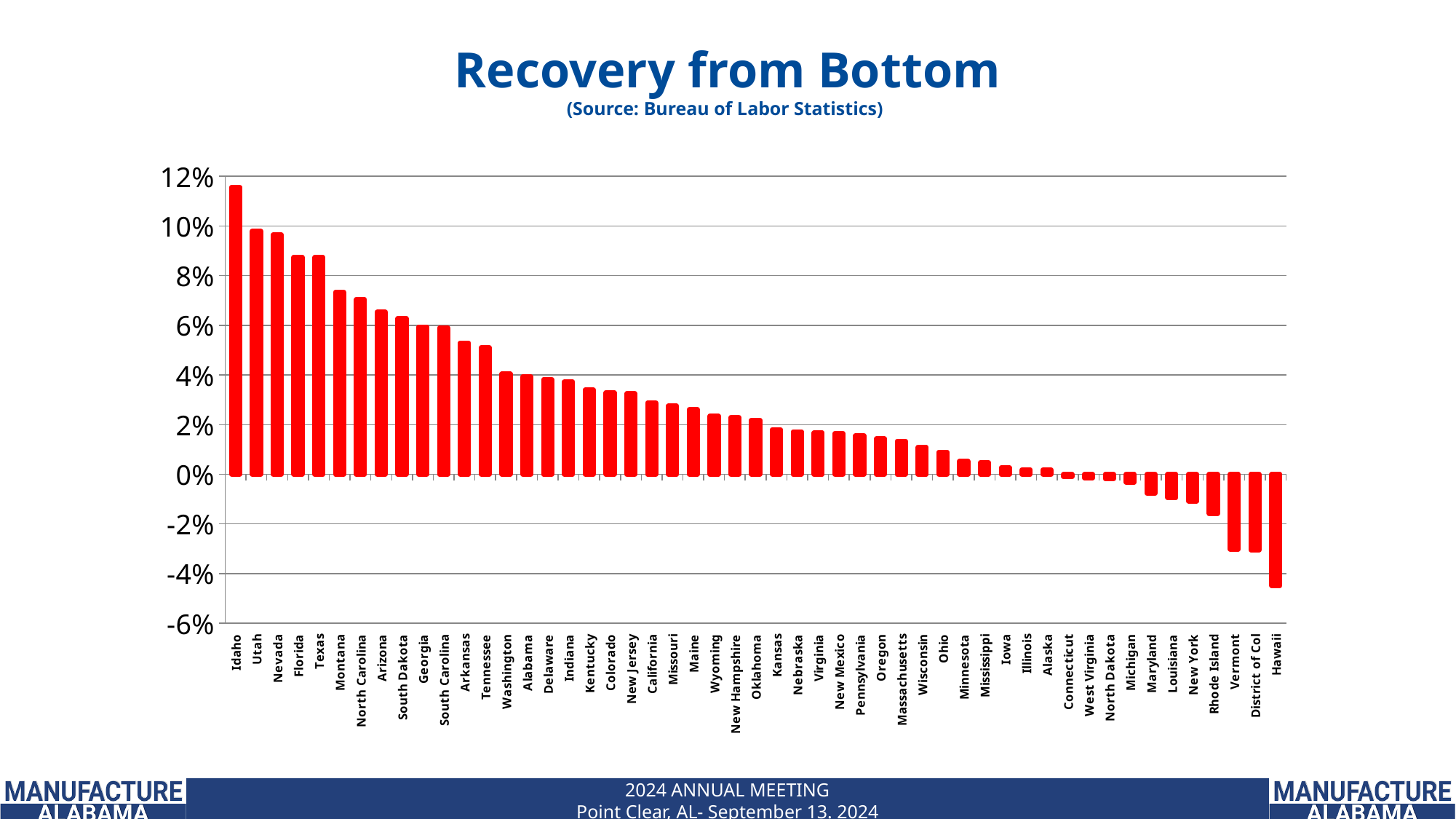
Is the value for Vermont greater or less than -2%? less What kind of chart is shown on the slide? bar chart Is the value for Montana greater or less than 6%? greater Which category has the lowest value on the chart? Hawaii Is the value for Alabama greater or less than 2%? greater Do the values rise or fall moving from left to right along the x axis? fall Which category has the highest value on the chart? Idaho Which has the larger value, Georgia or Alabama? Georgia How many states/jurisdictions are plotted on the chart? 51 What is the title of the chart? Recovery from Bottom